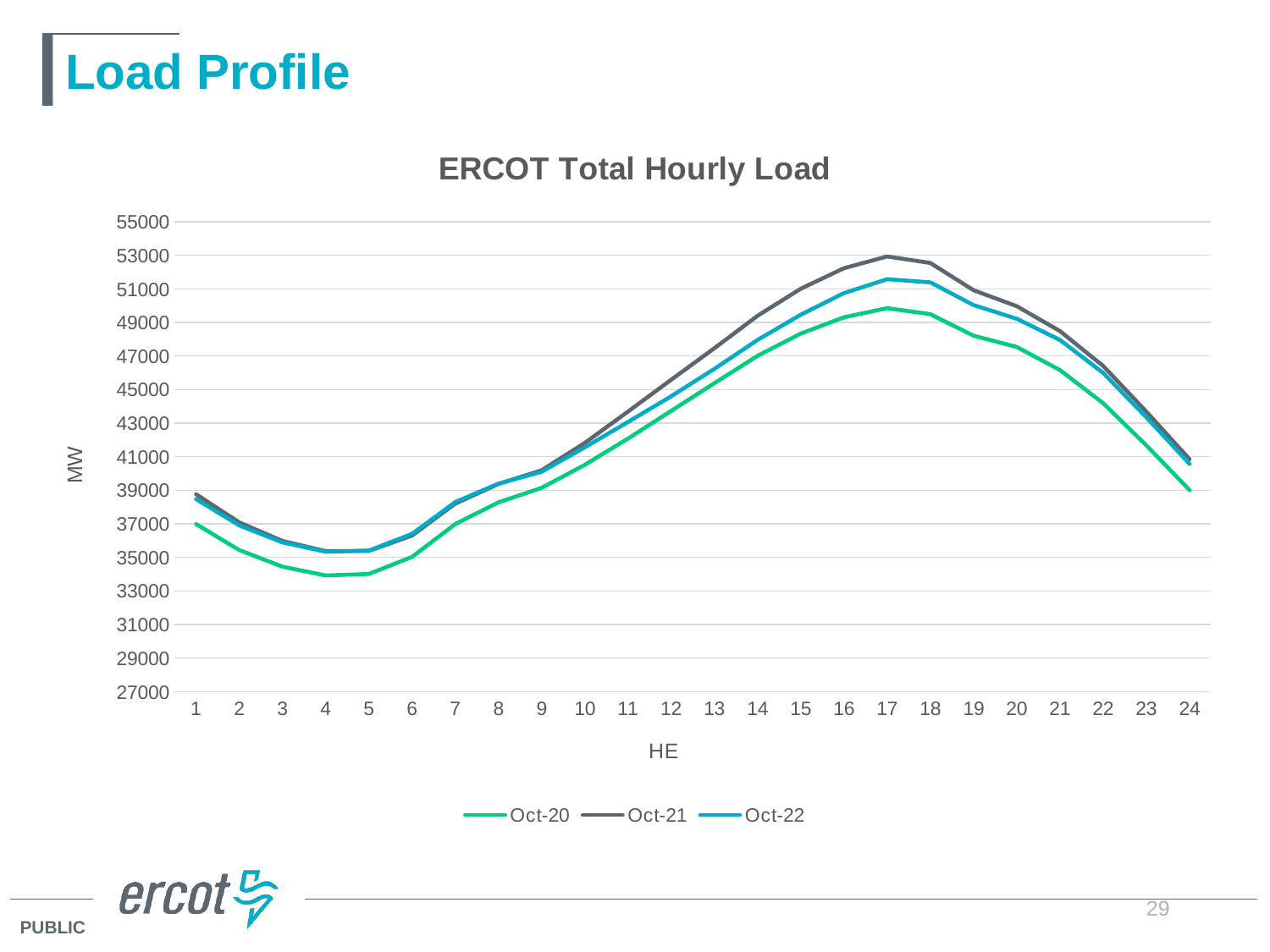
What is the title of the chart? ERCOT Total Hourly Load Which series has the lowest value at HE 17? Oct-20 At which hour (HE) does the Oct-21 series reach its highest value? 17 Is the Oct-21 value at HE 17 greater or less than 51000? greater Is the Oct-20 value at HE 4 greater or less than 35000? less Is the Oct-22 value at HE 24 greater or less than 39000? greater How many hours (HE values) are plotted along the x axis? 24 Do the Oct-20 values rise or fall from HE 17 to HE 24? fall What is the label on the y axis? MW What kind of chart is shown on the slide? Line chart At HE 17, which is larger: the Oct-21 value or the Oct-20 value? Oct-21 How many series does the legend list? 3